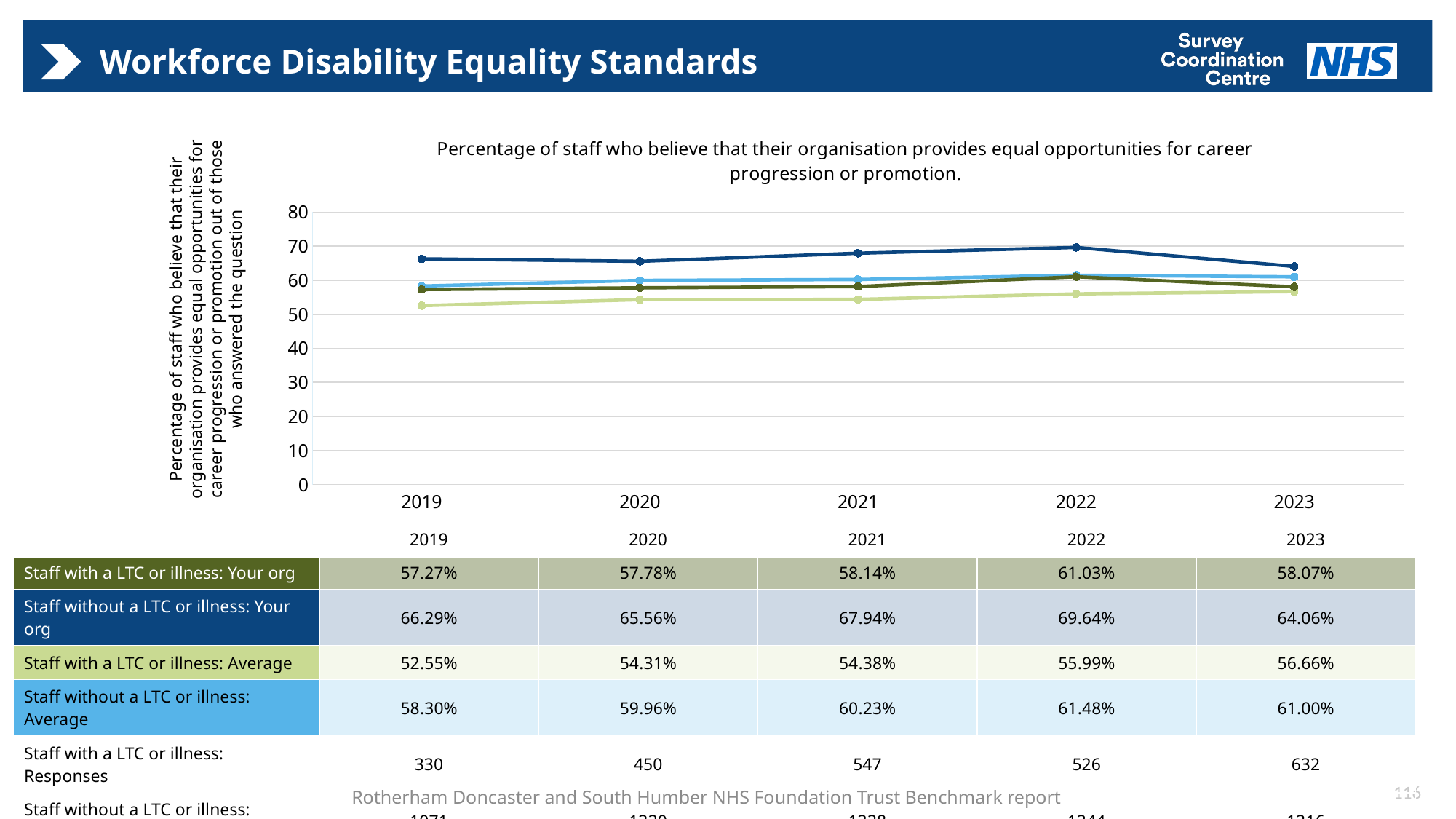
What is the value for Staff with a LTC or illness: Your org in 2022? 61.03% What is the value for Staff without a LTC or illness: Average in 2021? 60.23% What is the value for Staff with a LTC or illness: Average in 2019? 52.55% What is the difference between Staff without a LTC or illness: Your org and Staff with a LTC or illness: Your org in 2022? 8.61 percentage points In which year is the value for Staff without a LTC or illness: Your org highest? 2022 How many years are plotted on the x axis of the chart? 5 How many data series are plotted in the chart? 4 What kind of chart is shown on the slide? line chart What is the value for Staff without a LTC or illness: Your org in 2023? 64.06% Does the value for Staff with a LTC or illness: Average rise or fall from 2019 to 2023? rise In which year is the value for Staff with a LTC or illness: Average lowest? 2019 Which is larger in 2023: Staff with a LTC or illness: Your org or Staff without a LTC or illness: Average? Staff without a LTC or illness: Average